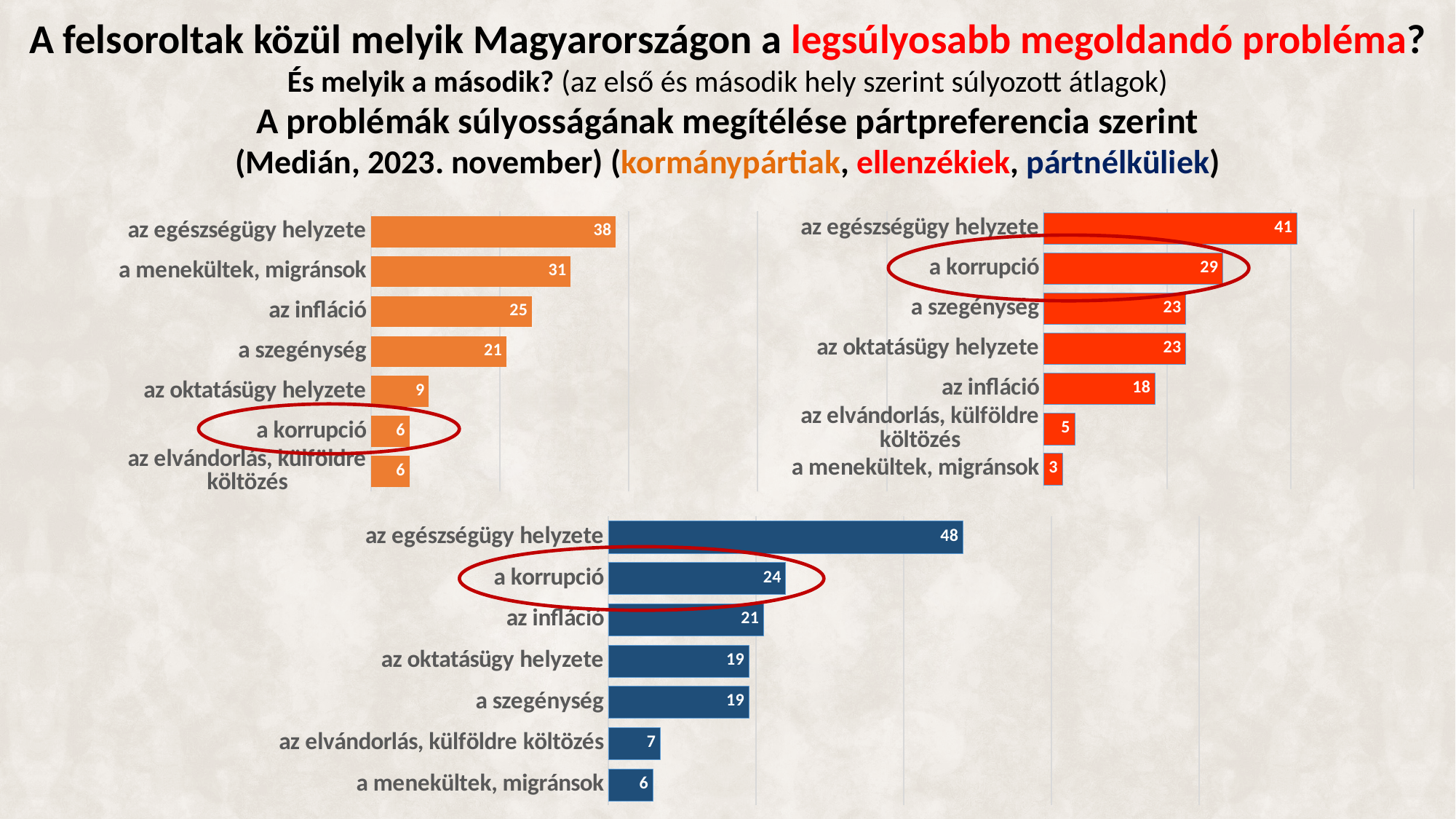
In the top-right chart, which is larger: 'a szegénység' or 'az infláció'? a szegénység In the top-right chart, what is the value for 'a korrupció'? 29 How many charts are on the slide? 3 In the bottom chart, what is the value for 'az infláció'? 21 In the bottom chart, which category has the highest value? az egészségügy helyzete How many categories does the bottom chart show? 7 In the top-left chart, which is larger: 'az infláció' or 'az oktatásügy helyzete'? az infláció In the top-left chart, what is the value for 'a menekültek, migránsok'? 31 In the top-right chart, which category has the lowest value? a menekültek, migránsok What type of chart is the top-right chart? bar chart In the top-left chart, what is the difference between 'az egészségügy helyzete' and 'a korrupció'? 32 In the bottom chart, what is the difference between 'az egészségügy helyzete' and 'a korrupció'? 24